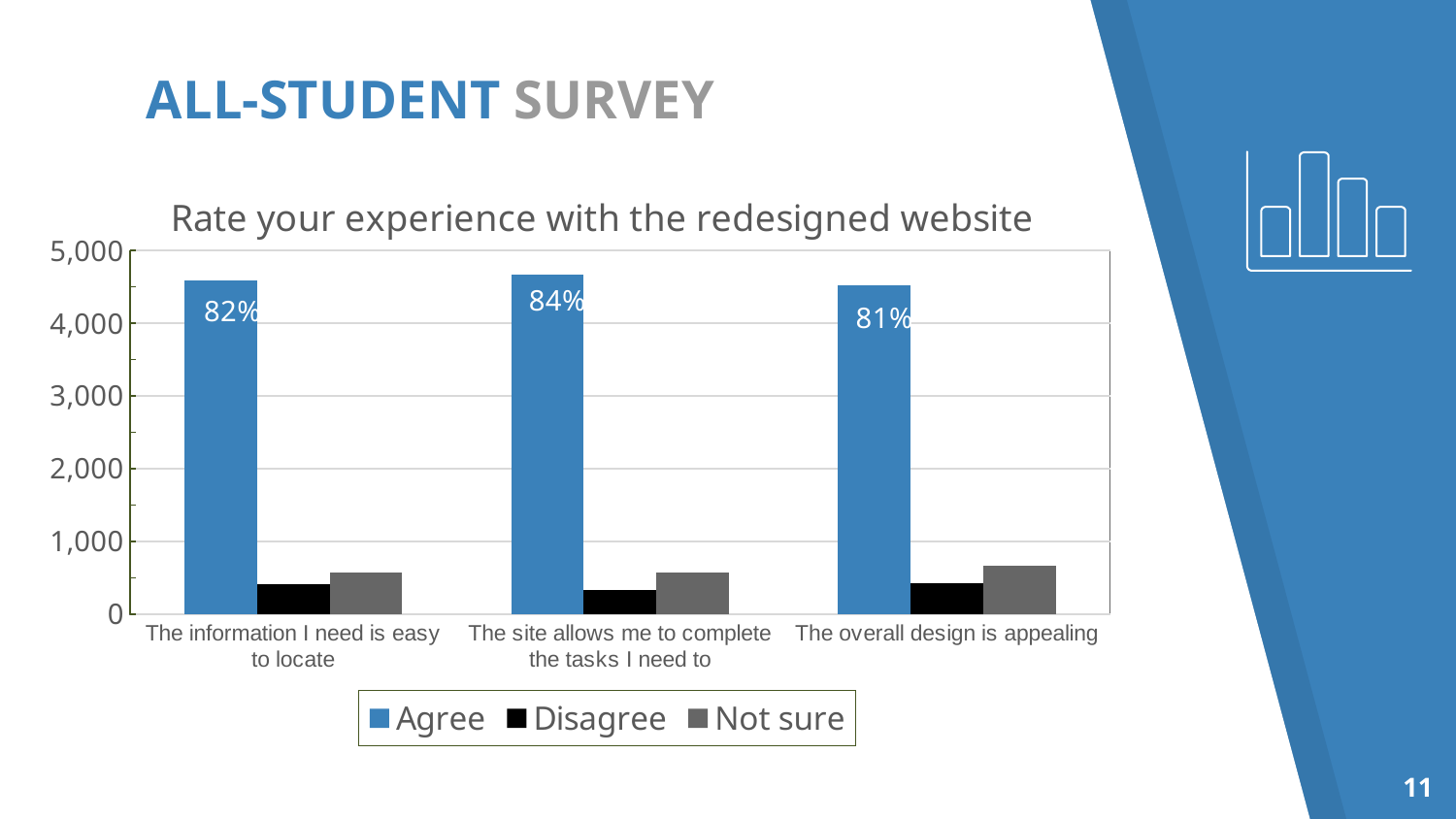
How many series does the legend list? 3 What is the title of the chart? Rate your experience with the redesigned website Which statement has the lowest Agree percentage? The overall design is appealing Is the Agree value for "The information I need is easy to locate" greater or less than 4,000? greater What is the difference between the Agree percentages for "The site allows me to complete the tasks I need to" and "The overall design is appealing"? 3% Is the Disagree value for "The overall design is appealing" greater or less than 1,000? less Which statement has the highest Agree percentage? The site allows me to complete the tasks I need to How many statements (categories) are shown on the x axis? 3 What percentage label is shown on the Agree bar for "The overall design is appealing"? 81% For "The overall design is appealing", which is larger: the Disagree bar or the Not sure bar? Not sure What percentage label is shown on the Agree bar for "The site allows me to complete the tasks I need to"? 84% What percentage label is shown on the Agree bar for "The information I need is easy to locate"? 82%